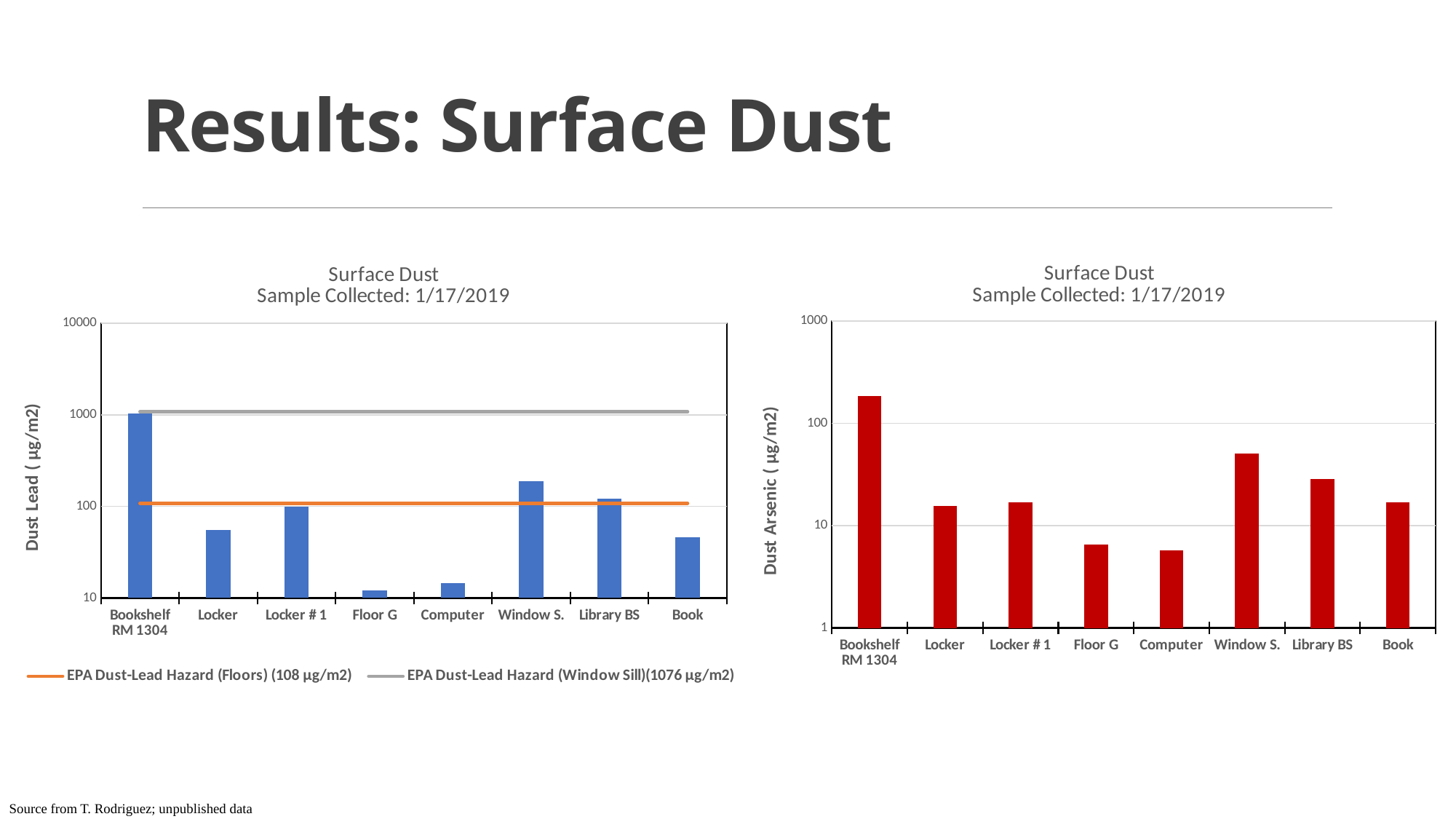
On the right chart (Dust Arsenic), is the value for Bookshelf RM 1304 greater or less than 100? greater On the right chart (Dust Arsenic), which category has the highest value? Bookshelf RM 1304 On the left chart (Dust Lead), which category has the highest value? Bookshelf RM 1304 On the left chart (Dust Lead), is the value for Window S. greater or less than 100? greater On the left chart (Dust Lead), is the value for Locker greater or less than 100? less How many entries does the legend below the left chart (Dust Lead) list? 2 What is the y-axis label of the left chart? Dust Lead ( µg/m2) How many categories are shown on the x axis of the right chart (Dust Arsenic)? 8 What kind of chart is the right chart (Dust Arsenic)? Bar chart On the right chart (Dust Arsenic), which is larger, the value for Window S. or the value for Library BS? Window S. On the left chart (Dust Lead), which is larger, the value for Window S. or the value for Book? Window S.